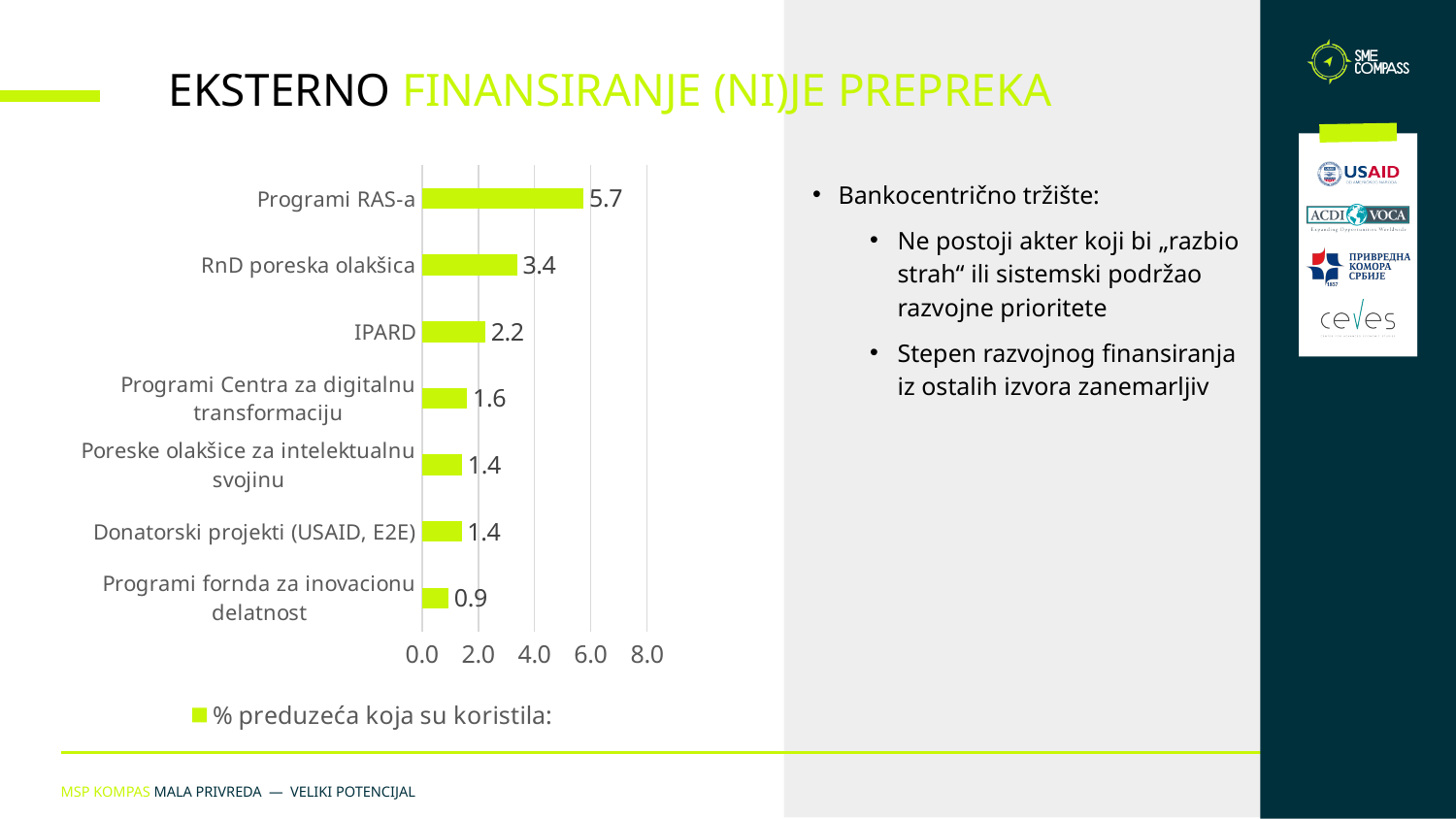
Is the value for RnD poreska olakšica greater or less than 4.0? less What is the legend entry of the chart? % preduzeća koja su koristila: Which category has the highest value? Programi RAS-a Which is larger, the value for IPARD or the value for Programi Centra za digitalnu transformaciju? IPARD Which category has the lowest value? Programi fornda za inovacionu delatnost What kind of chart is shown on the slide? bar chart What is the difference between the values for Programi RAS-a and RnD poreska olakšica? 2.3 How many categories are shown in the chart? 7 How many series does the legend list? 1 What is the value for Programi fornda za inovacionu delatnost? 0.9 What is the value for IPARD? 2.2 What is the value for Programi RAS-a? 5.7